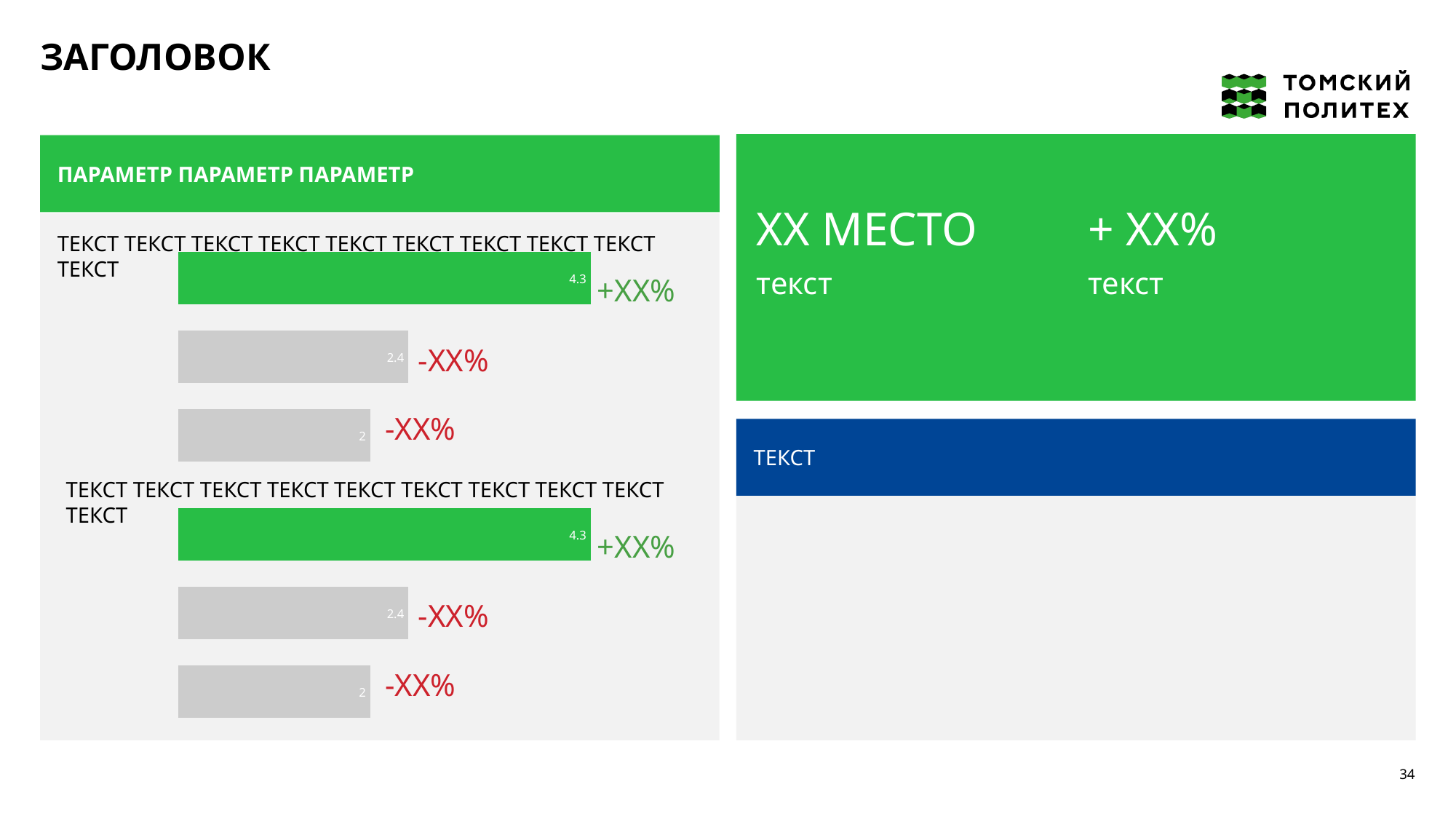
In the lower chart of the left panel, do the bar values increase or decrease from the top bar to the bottom bar? decrease In the upper chart of the left panel, what is the value labelled on the bottom bar? 2 In the lower chart of the left panel, which is larger: the middle bar or the bottom bar? the middle bar In the upper chart of the left panel, what colour is the bar with the value 4.3? green What kind of chart is shown in the upper chart of the left panel? bar chart In the upper chart of the left panel, what is the highest value shown? 4.3 In the upper chart of the left panel, what is the difference between the top bar (4.3) and the middle bar (2.4)? 1.9 In the lower chart of the left panel, what is the lowest value shown? 2 In the upper chart of the left panel, how many bars are plotted? 3 In the upper chart of the left panel, what is the value labelled on the top (green) bar? 4.3 In the lower chart of the left panel, what is the difference between the top bar (4.3) and the bottom bar (2)? 2.3 In the upper chart of the left panel, what is the value labelled on the middle bar? 2.4